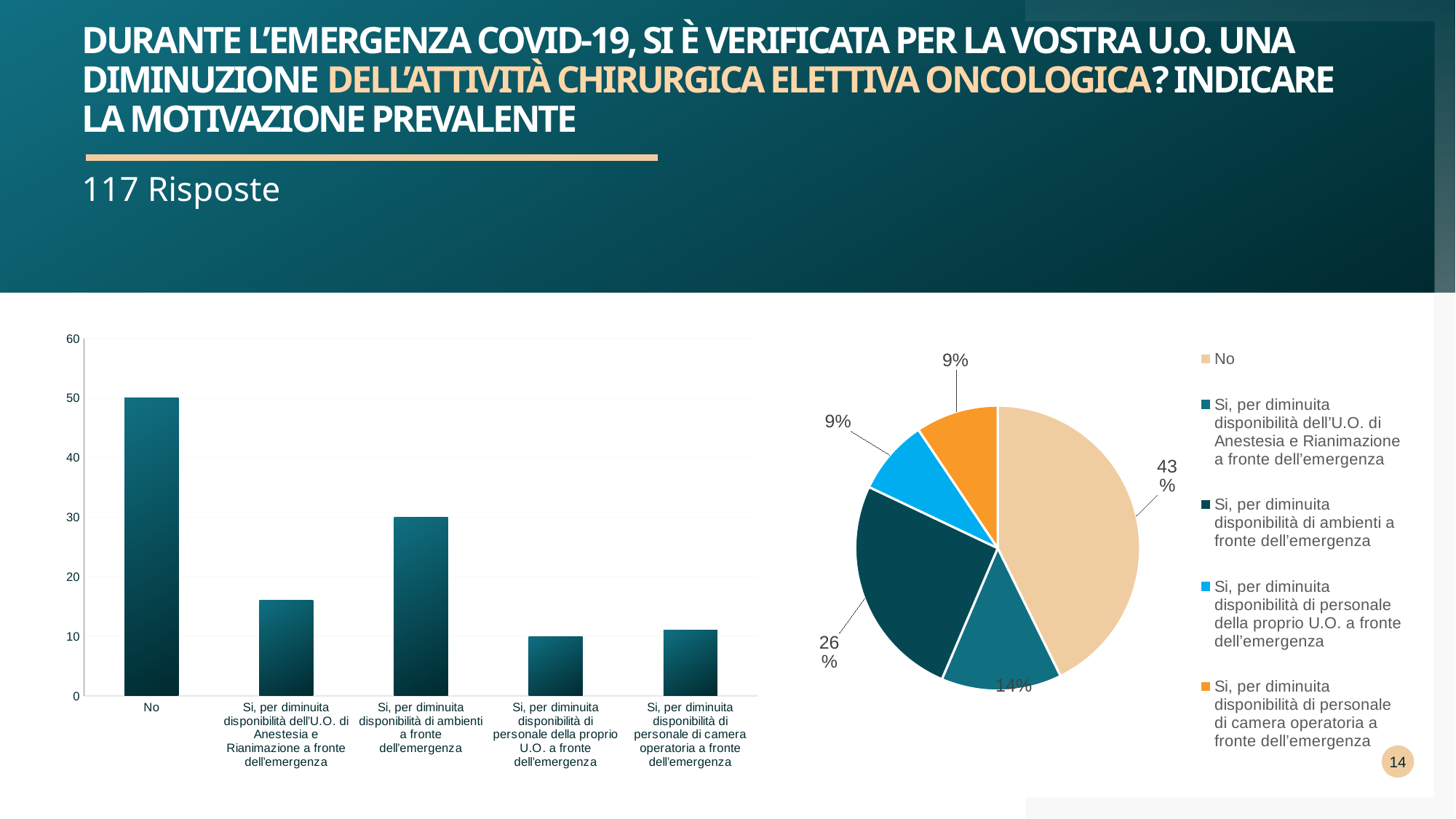
In the pie chart on the right, what is the difference between the "No" share and the "Si, per diminuita disponibilità di ambienti a fronte dell'emergenza" share? 17% What kind of chart is the chart on the right of the slide? Pie chart In the pie chart on the right, what share does the "No" slice have? 43% In the bar chart on the left, how many categories are shown on the x axis? 5 In the bar chart on the left, which is larger: the value for "No" or the value for "Si, per diminuita disponibilità di ambienti a fronte dell'emergenza"? No In the bar chart on the left, is the value for "Si, per diminuita disponibilità dell'U.O. di Anestesia e Rianimazione a fronte dell'emergenza" greater or less than 20? less In the bar chart on the left, what is the value for "Si, per diminuita disponibilità di ambienti a fronte dell'emergenza"? 30 In the pie chart on the right, what share does "Si, per diminuita disponibilità di ambienti a fronte dell'emergenza" have? 26% What kind of chart is the chart on the left of the slide? Bar chart In the bar chart on the left, which category has the highest bar? No In the bar chart on the left, what is the value for "No"? 50 How many entries does the legend of the pie chart on the right list? 5